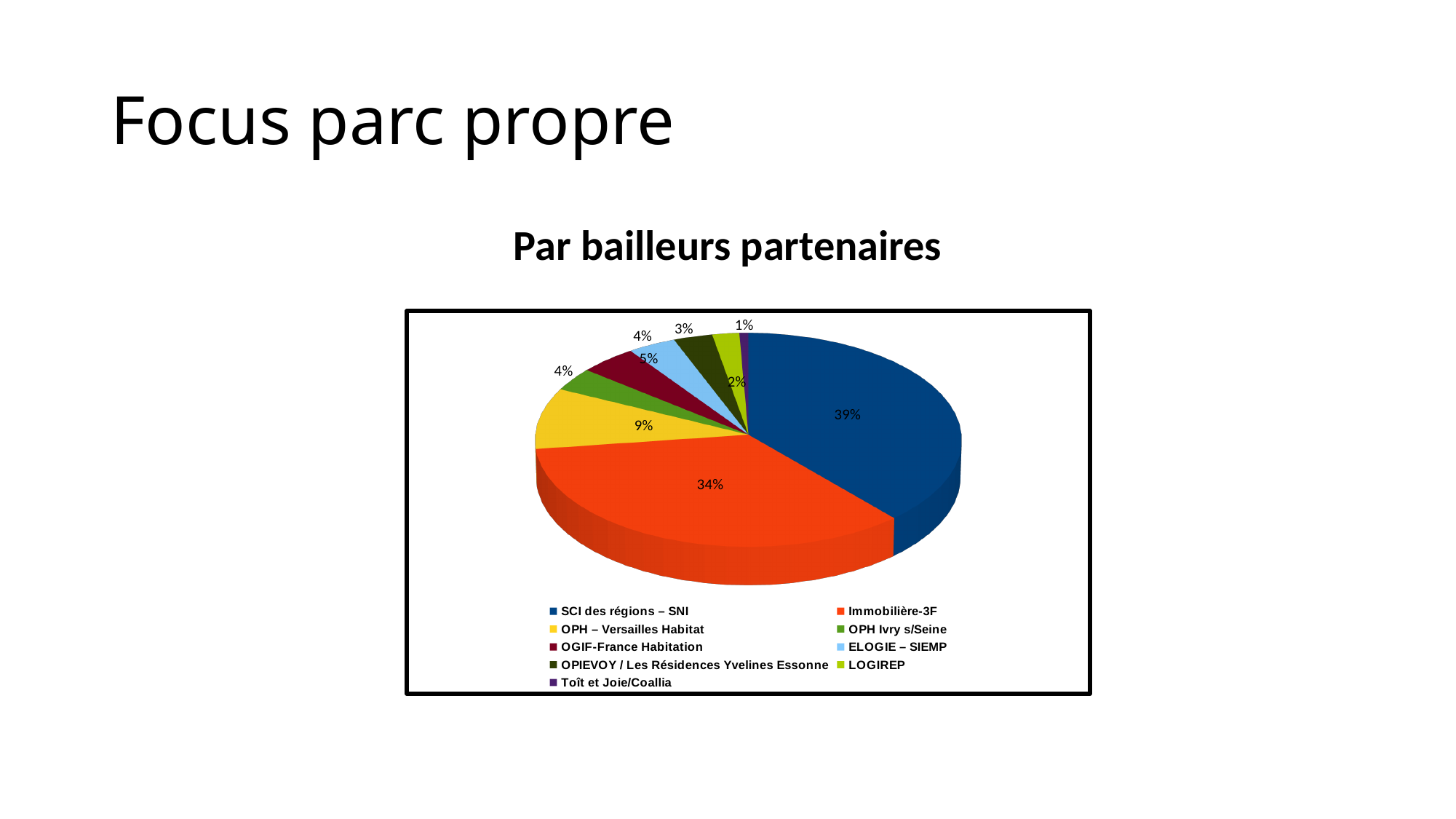
How many bailleurs are listed in the legend? 9 Which bailleur has the smallest share of the pie? Toît et Joie/Coallia Which has a larger share, OPH – Versailles Habitat or OGIF-France Habitation? OPH – Versailles Habitat What percentage is shown for Immobilière-3F? 34% What type of chart is shown on the slide? Pie chart What percentage is shown for OGIF-France Habitation? 5% What is the difference in percentage points between SCI des régions – SNI and Immobilière-3F? 5 What colour is the slice for Immobilière-3F? Orange What share of the pie does SCI des régions – SNI hold? 39% What percentage is shown for OPH – Versailles Habitat? 9% What is the title of the chart? Par bailleurs partenaires Which bailleur has the largest share of the pie? SCI des régions – SNI